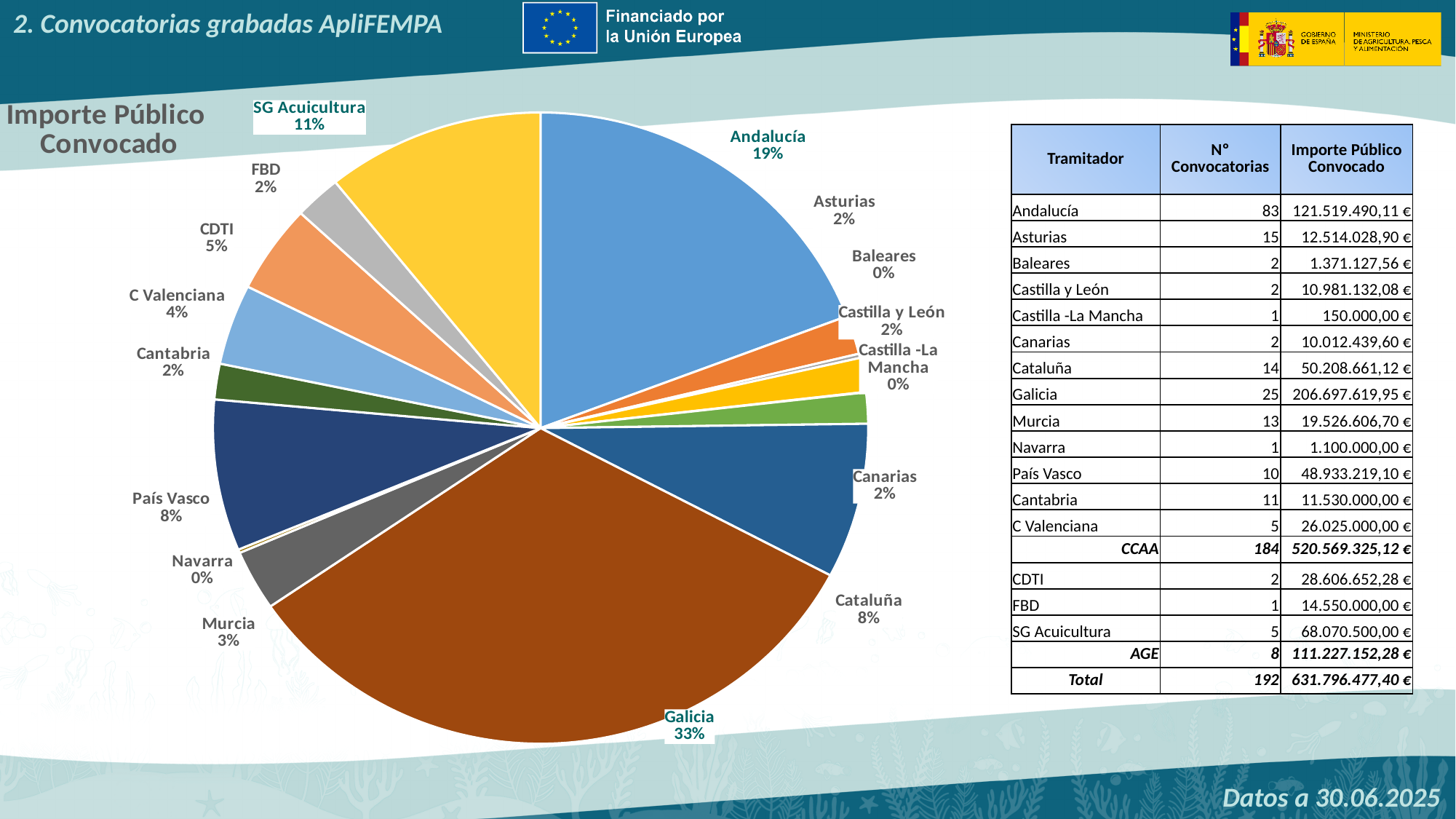
What share of the pie does SG Acuicultura represent? 11% What percentage is shown for CDTI? 5% What type of chart is shown on the slide? pie chart Which has a larger share, SG Acuicultura or Cataluña? SG Acuicultura How many slices does the pie chart have? 16 Which category has the largest slice of the pie? Galicia What percentage is shown for Murcia? 3% What is the title of the chart? Importe Público Convocado Which has a larger share, País Vasco or C Valenciana? País Vasco What share of the pie does Galicia represent? 33% What share of the pie does Andalucía represent? 19% What is the difference in percentage points between Galicia and Andalucía? 14